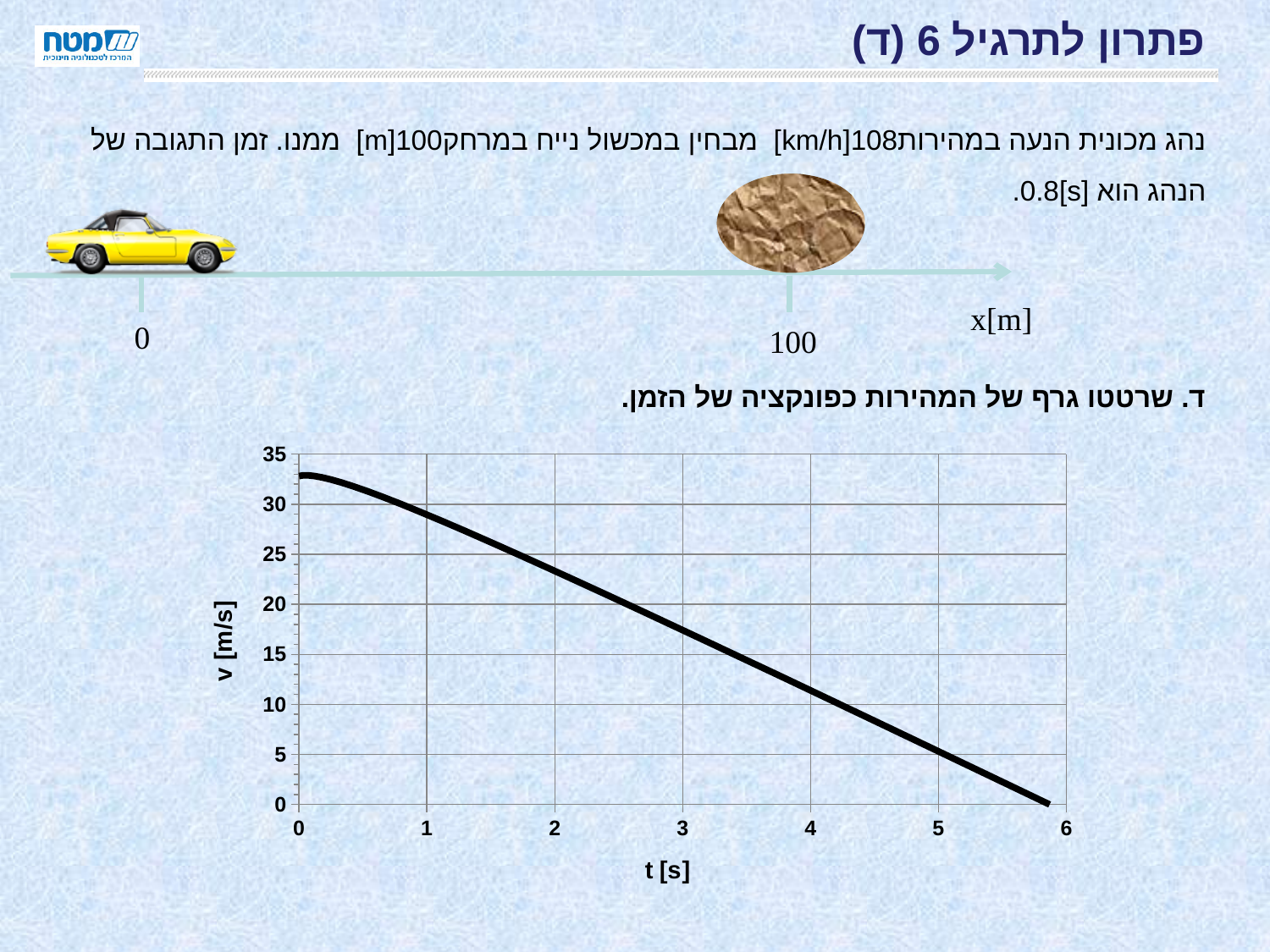
Is the value of v at t = 1 s greater or less than 25 m/s? greater What is the label of the horizontal axis of the chart? t [s] Is the value of v at t = 4 s greater or less than 15 m/s? less Which is larger, the velocity at t = 1 s or the velocity at t = 5 s? t = 1 s What is the label of the vertical axis of the chart? v [m/s] What kind of chart is shown on the slide? line chart At which time on the x axis is the velocity v highest? t = 0 s Does the velocity v rise or fall as time t increases along the x axis? fall Is the value of v at t = 0 s greater or less than 30 m/s? greater